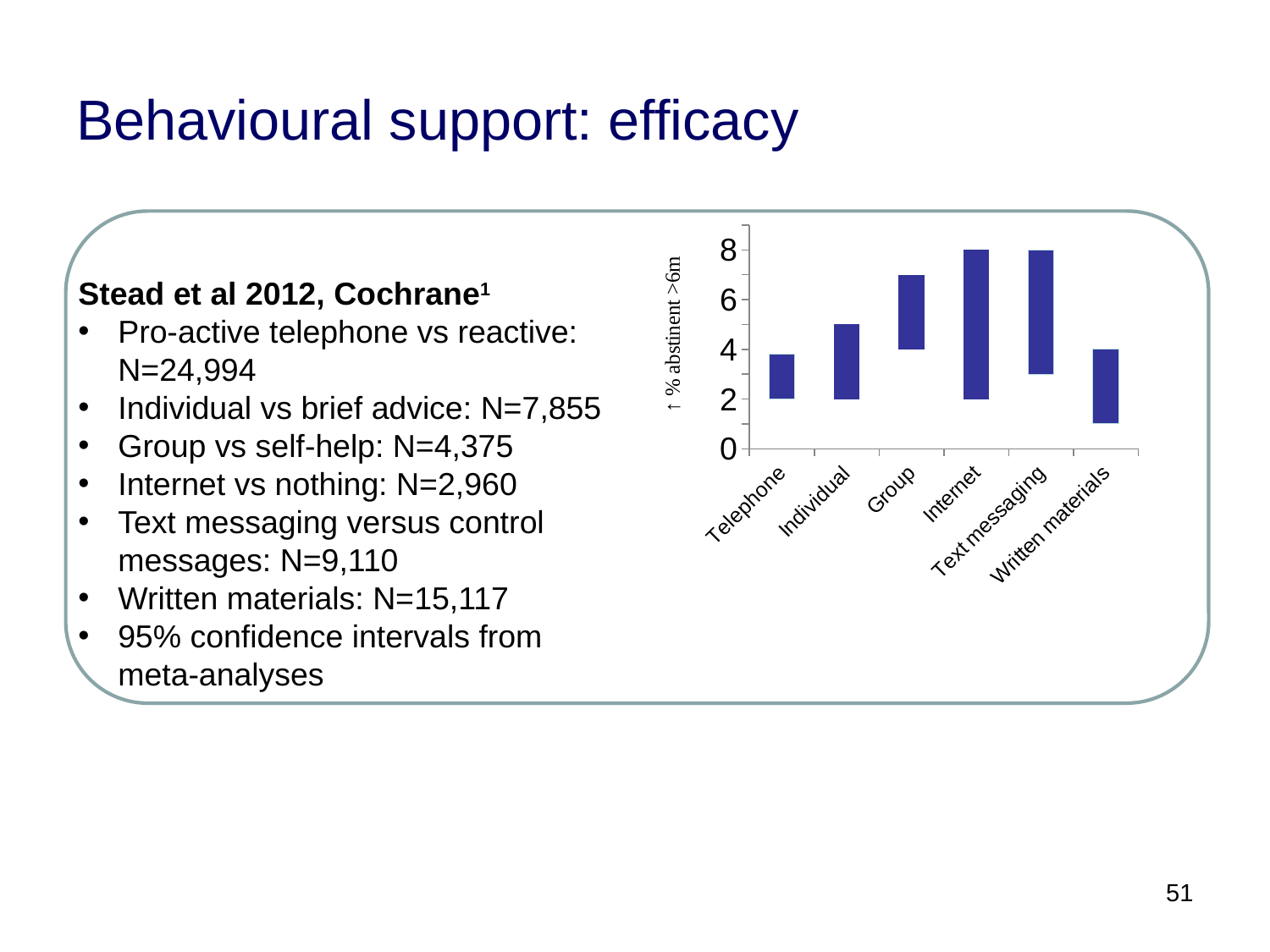
What is the label on the y axis of the chart? ↑ % abstinent >6m What is the upper end of the Written materials bar in the chart? 4 What is the lower end of the Internet bar in the chart? 2 How many categories are shown on the x axis of the chart? 6 What is the upper end of the Internet bar in the chart? 8 Which category has the lowest bottom end of its bar in the chart? Written materials Is the lower end of the Group bar greater or less than 2? greater Which category has the narrowest bar (smallest confidence interval) in the chart? Telephone Which category has the widest bar (largest confidence interval) in the chart? Internet Is the upper end of the Written materials bar greater or less than 6? less Is the upper end of the Individual bar greater or less than 4? greater What kind of chart is shown on the slide? bar chart